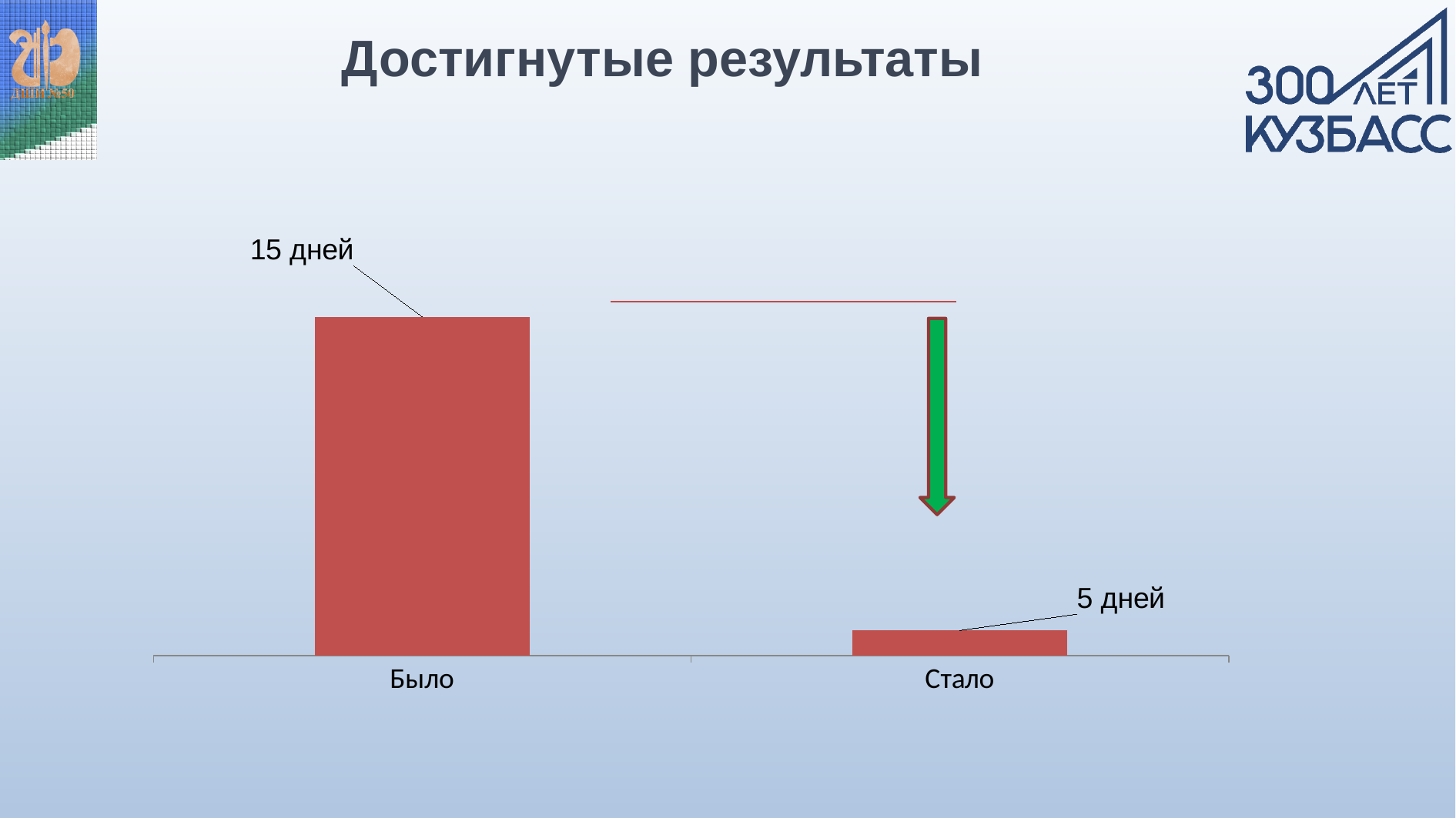
How many categories are shown on the chart? 2 What is the title of the slide containing the chart? Достигнутые результаты Which category has the lowest value? Стало Which is larger, the value for "Было" or the value for "Стало"? Было What kind of chart is shown on the slide? bar chart What colour are the bars in the chart? red What is the value for "Стало"? 5 дней What is the difference between the values for "Было" and "Стало"? 10 дней Do the values rise or fall from "Было" to "Стало"? fall What is the value for "Было"? 15 дней Which category has the highest value? Было